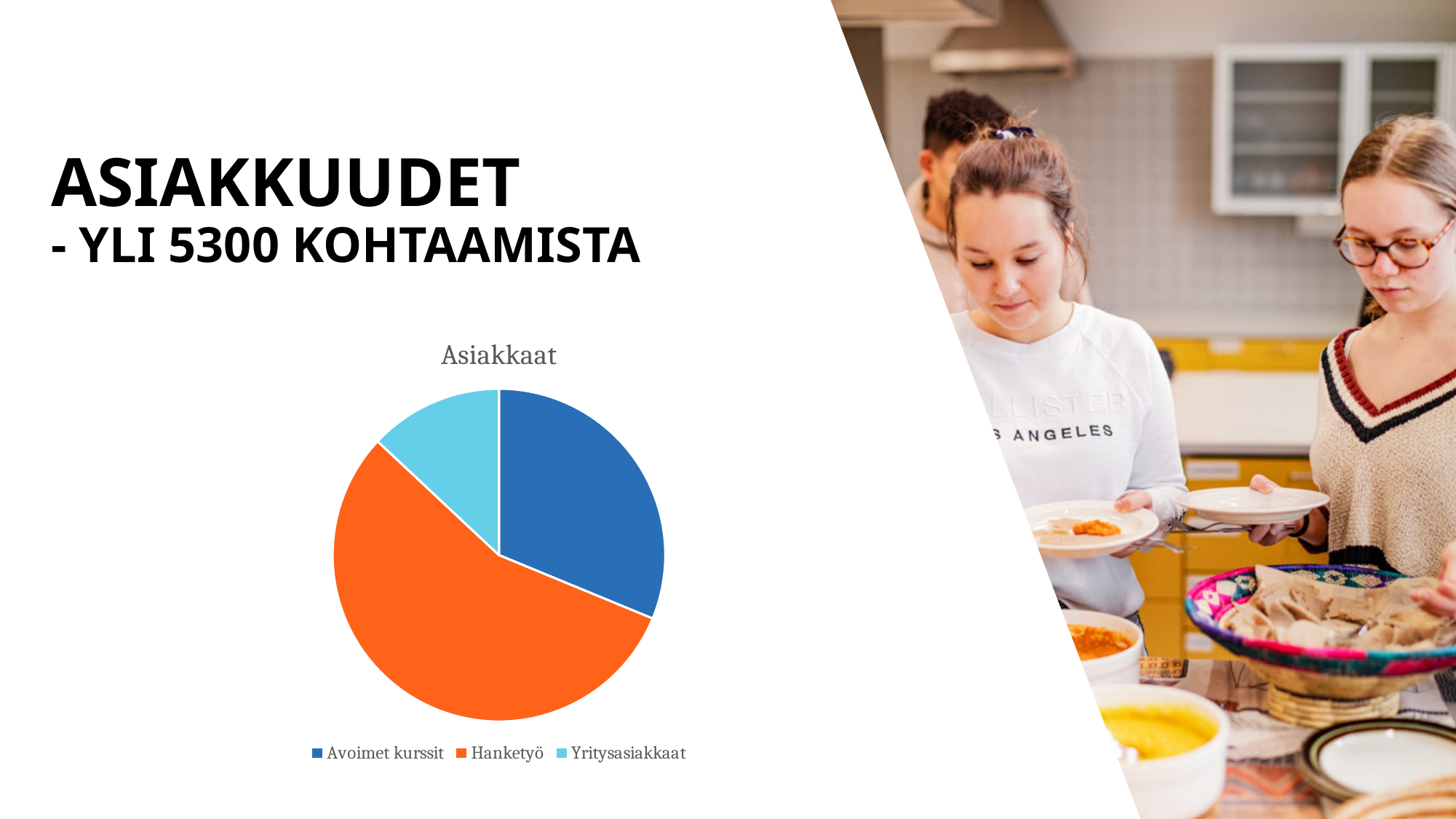
How many slices does the pie chart have? 3 Which slice is larger, Avoimet kurssit or Yritysasiakkaat? Avoimet kurssit What is the title of the pie chart? Asiakkaat Which category has the smallest slice in the pie chart? Yritysasiakkaat Which colour represents Hanketyö in the pie chart? orange How many entries does the legend of the pie chart list? 3 Which category has the largest slice in the pie chart? Hanketyö What kind of chart is shown on the slide? pie chart Which slice is larger, Hanketyö or Avoimet kurssit? Hanketyö